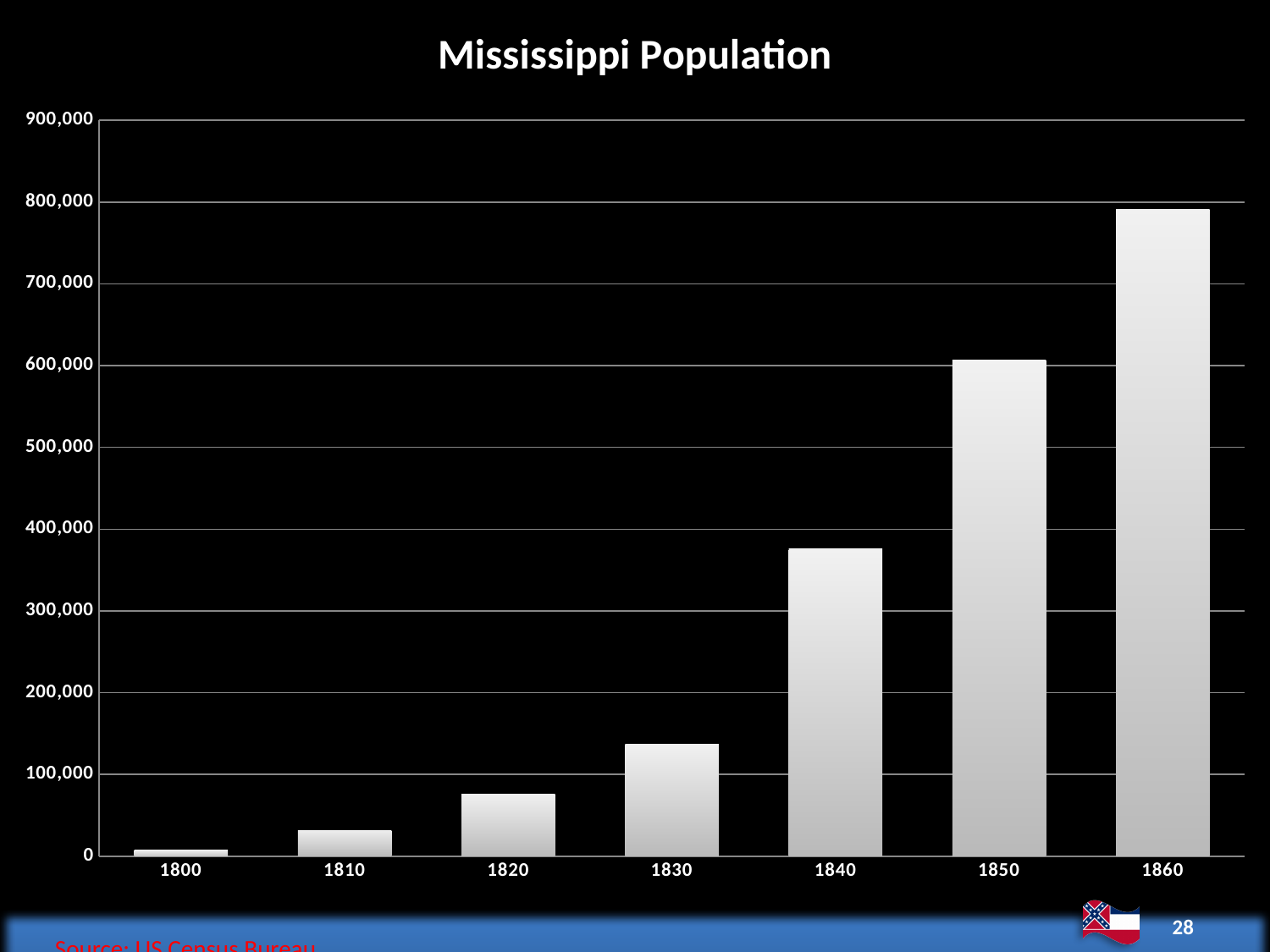
Is the population for 1850 greater or less than 500,000? greater Which year has the larger population, 1840 or 1850? 1850 Is the population for 1840 greater or less than 400,000? less Do the population values rise or fall from 1800 to 1860? rise What kind of chart is shown on the slide? Bar chart Is the population for 1830 greater or less than 100,000? greater What is the title of the chart? Mississippi Population Which year has the highest population in the chart? 1860 Which year has the lowest population in the chart? 1800 How many years are shown on the x axis of the chart? 7